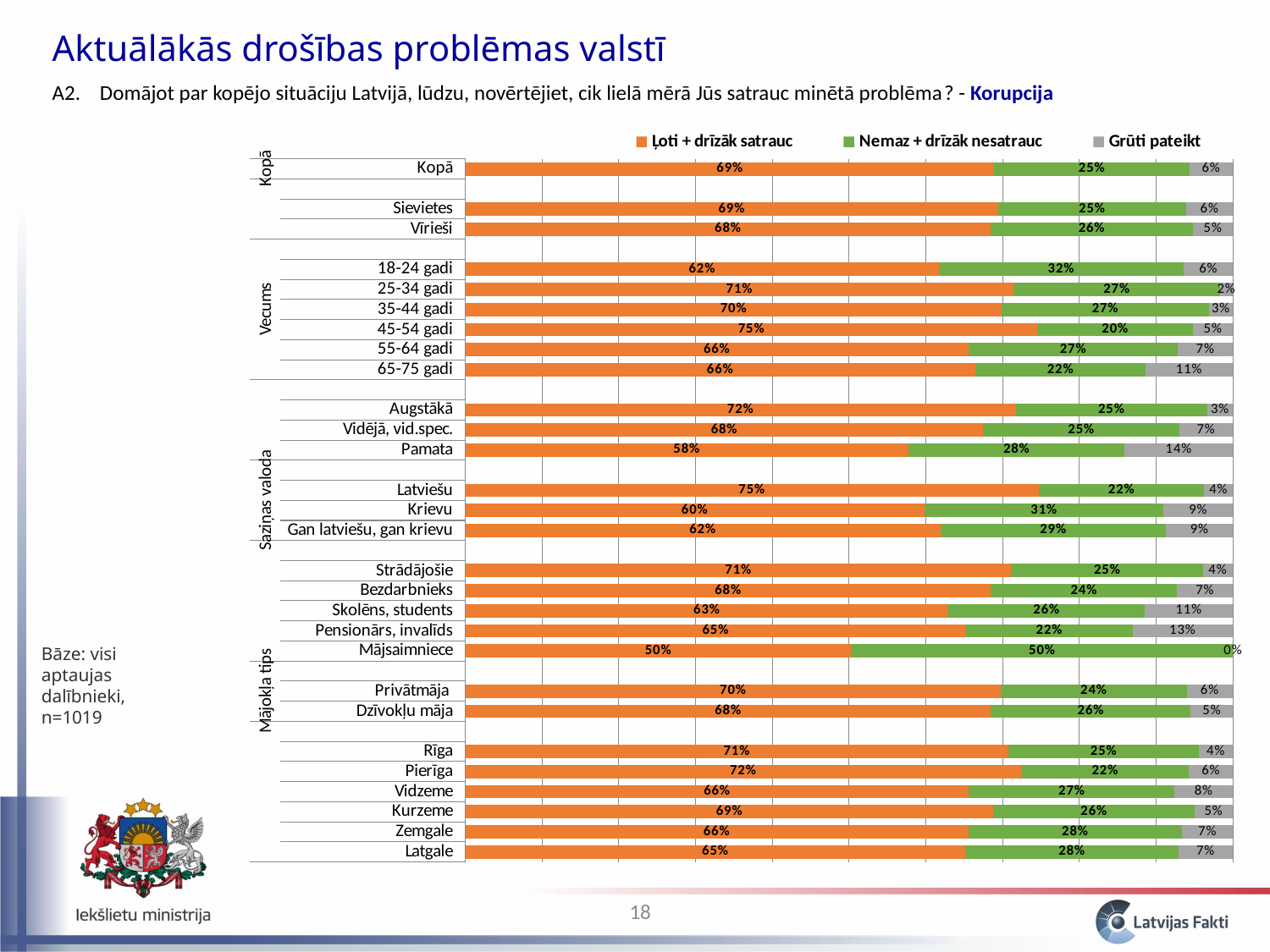
What is the value of "Nemaz + drīzāk nesatrauc" for 18-24 gadi? 32% How many categories are plotted on the chart? 28 Which series is shown in orange in the legend? Ļoti + drīzāk satrauc Which category has the highest value for "Grūti pateikt"? Pamata What is the total of the stacked bar for Mājsaimniece? 100% How many series does the legend list? 3 What is the difference between the "Ļoti + drīzāk satrauc" values for Latviešu and Krievu? 15% What is the value of "Ļoti + drīzāk satrauc" for Kopā? 69% What is the value of "Grūti pateikt" for Pamata? 14% Which has a larger "Ļoti + drīzāk satrauc" value, Rīga or Vidzeme? Rīga Which category has the lowest value for "Ļoti + drīzāk satrauc"? Mājsaimniece What kind of chart is shown on the slide? Stacked bar chart